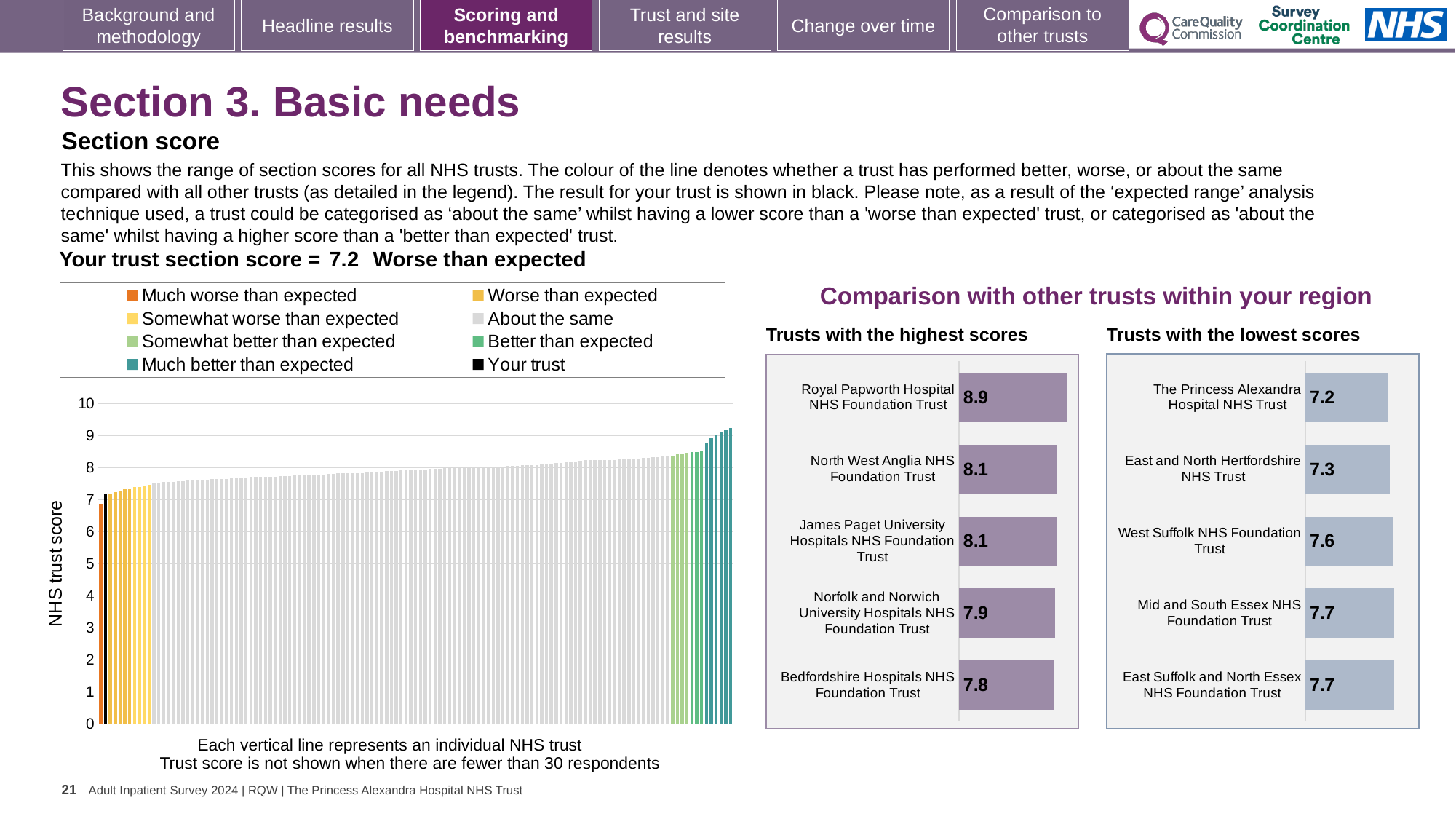
In the main 'NHS trust score' chart, do the bar values rise or fall from left to right? Rise In the 'Trusts with the lowest scores' chart, which has the larger score: East and North Hertfordshire NHS Trust or Mid and South Essex NHS Foundation Trust? Mid and South Essex NHS Foundation Trust In the 'Trusts with the highest scores' chart, what is the difference between the scores of Royal Papworth Hospital NHS Foundation Trust and Bedfordshire Hospitals NHS Foundation Trust? 1.1 In the 'Trusts with the lowest scores' chart, what is the score for West Suffolk NHS Foundation Trust? 7.6 What kind of chart is the main 'NHS trust score' chart on the left? Bar chart How many trusts are shown in the 'Trusts with the highest scores' chart? 5 In the main 'NHS trust score' chart, what colour does the legend assign to 'Your trust'? Black In the main 'NHS trust score' chart, is the value of the tallest bar on the far right greater or less than 9? greater In the 'Trusts with the lowest scores' chart, which trust has the lowest score? The Princess Alexandra Hospital NHS Trust In the 'Trusts with the highest scores' chart, which trust has the highest score? Royal Papworth Hospital NHS Foundation Trust In the main 'NHS trust score' chart, how many entries does the legend list? 8 In the 'Trusts with the highest scores' chart, what is the score for Royal Papworth Hospital NHS Foundation Trust? 8.9